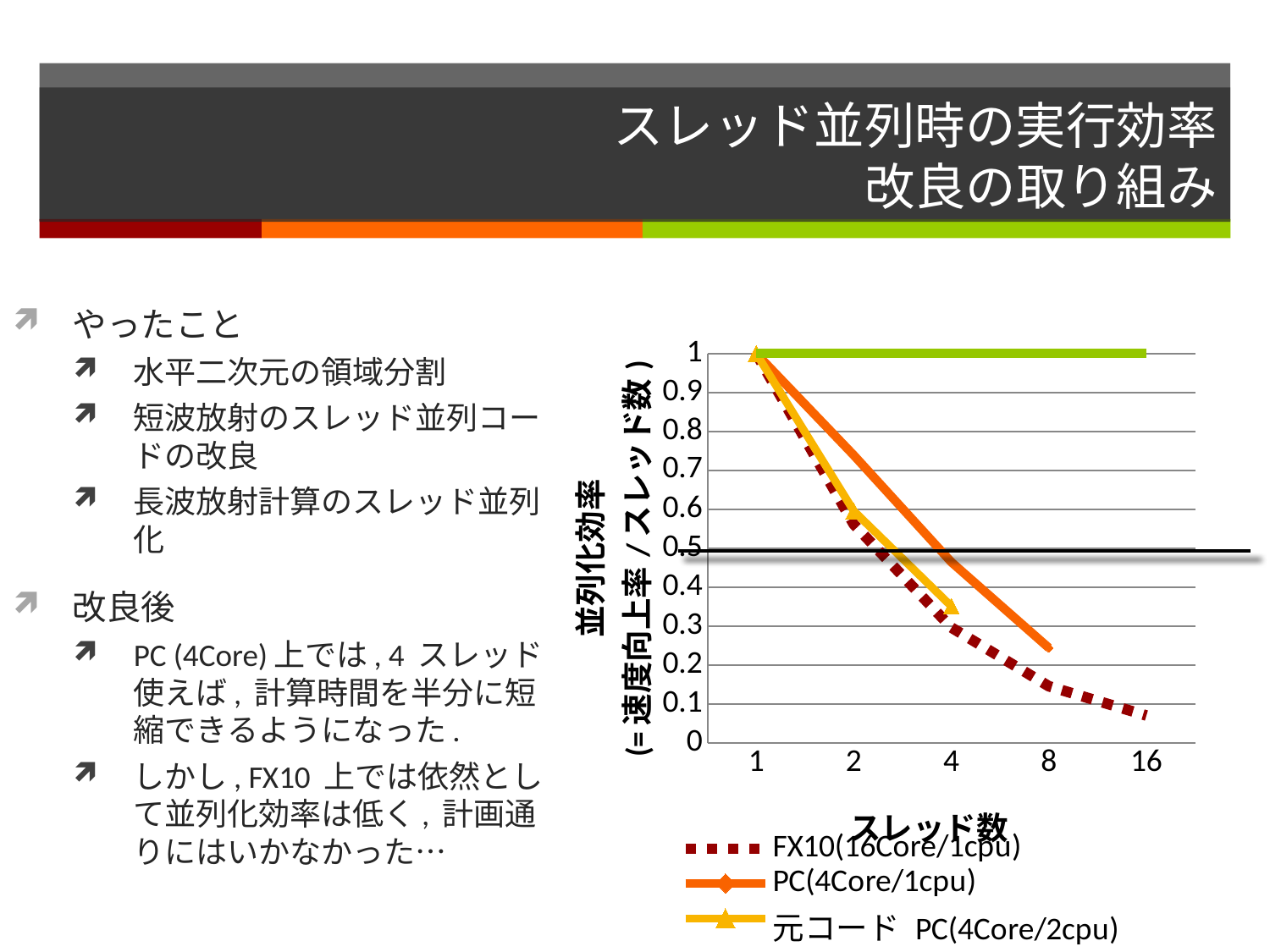
How many series does the chart legend list? 3 As the number of threads increases along the x axis, do the plotted efficiency values rise or fall? fall Is the value for PC(4Core/1cpu) at 2 threads greater or less than 0.5? greater Which legend series extends to 16 threads on the x axis? FX10(16Core/1cpu) What kind of chart is shown on the slide? line chart Which series in the legend is drawn as a dashed line? FX10(16Core/1cpu) Is the value for FX10(16Core/1cpu) at 16 threads greater or less than 0.2? less Is the value for FX10(16Core/1cpu) at 4 threads greater or less than 0.5? less What is the title of the x axis of the chart? スレッド数 How many thread-count values are marked on the x axis of the chart? 5 At 4 threads, which is larger: the value for PC(4Core/1cpu) or the value for FX10(16Core/1cpu)? PC(4Core/1cpu)